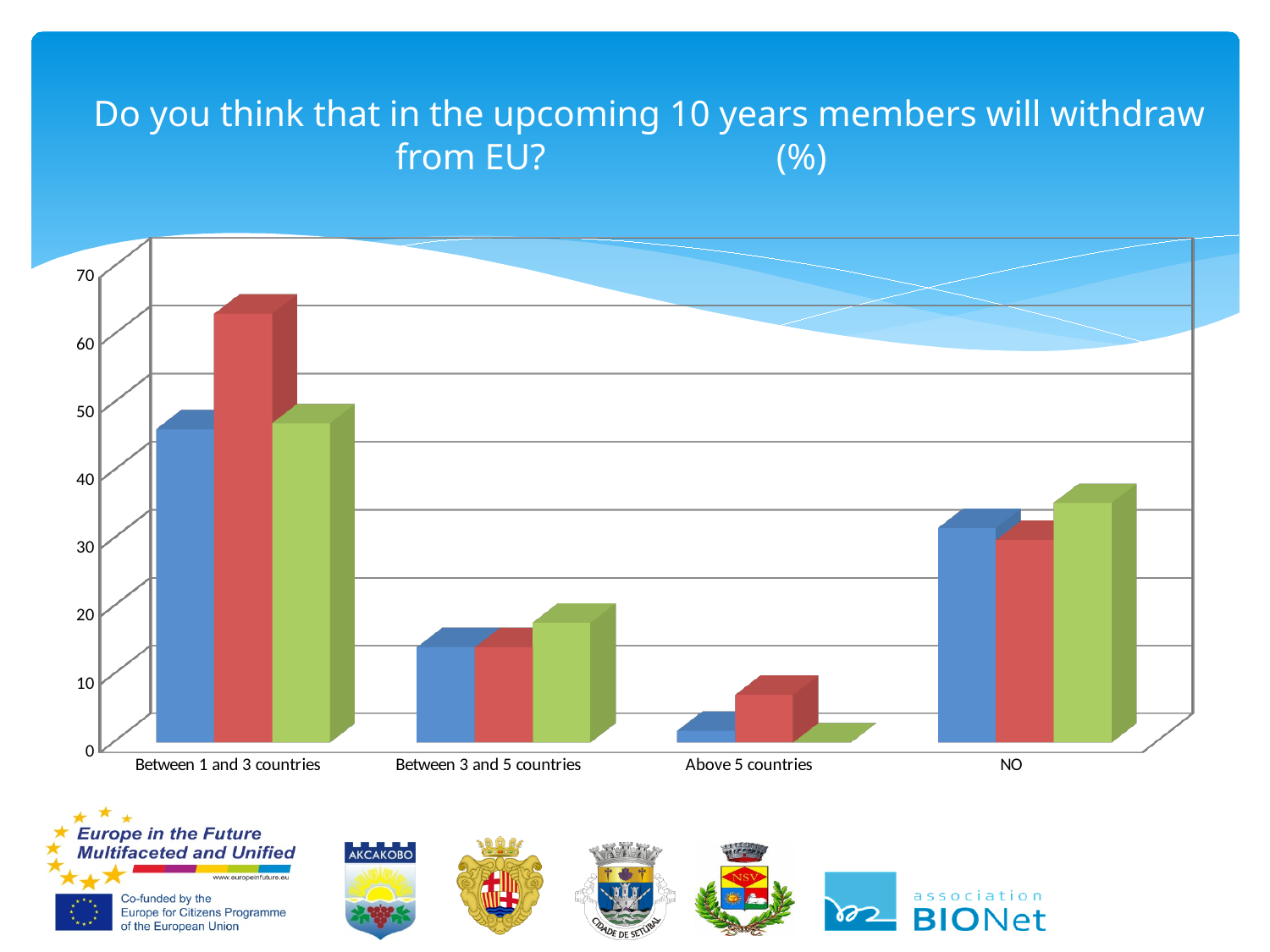
Which is larger: the red bar for 'Between 1 and 3 countries' or the red bar for 'NO'? Between 1 and 3 countries Is the value of the blue bar for 'Between 1 and 3 countries' greater or less than 40? greater What is the title of the chart? Do you think that in the upcoming 10 years members will withdraw from EU? (%) Which is larger: the blue bar for 'Between 3 and 5 countries' or the blue bar for 'NO'? NO Is the value of the green bar for 'NO' greater or less than 30? greater What kind of chart is shown on the slide? bar chart Which category has the lowest bars overall in the chart? Above 5 countries Is the value of the red bar for 'Between 1 and 3 countries' greater or less than 60? greater Which category has the tallest bar in the chart? Between 1 and 3 countries How many categories are shown on the x axis of the chart? 4